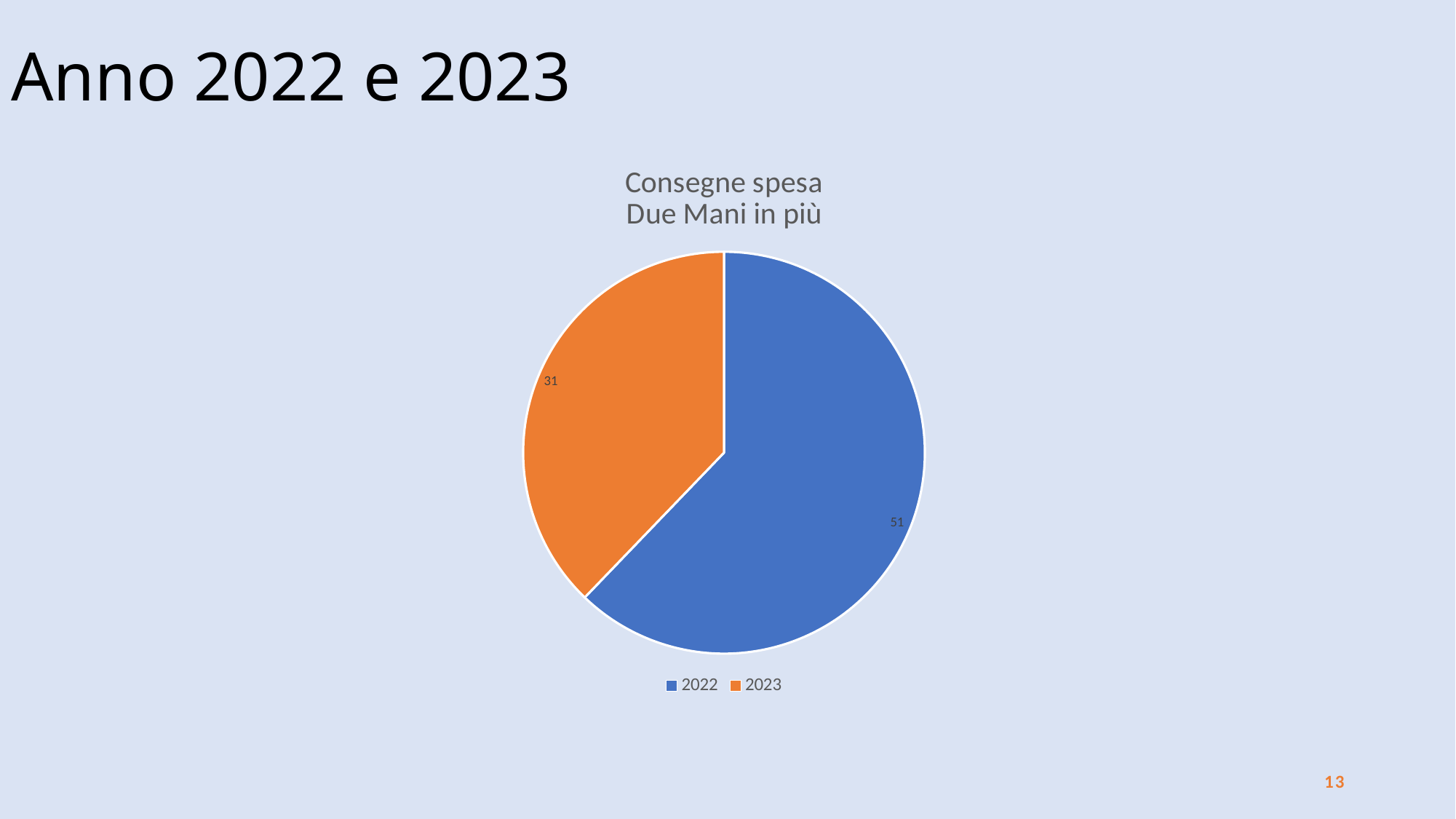
Which year has the larger slice of the pie? 2022 What is the total of the two slices in the pie chart? 82 Is the value for 2022 larger or smaller than the value for 2023? larger What is the title of the chart? Consegne spesa Due Mani in più What is the value for 2022 in the pie chart? 51 What is the difference between the values for 2022 and 2023? 20 How many slices does the pie chart have? 2 Which year has the smaller slice of the pie? 2023 What kind of chart is shown on the slide? pie chart What is the value for 2023 in the pie chart? 31 How many entries does the legend list? 2 Which colour represents 2023 in the pie chart? orange